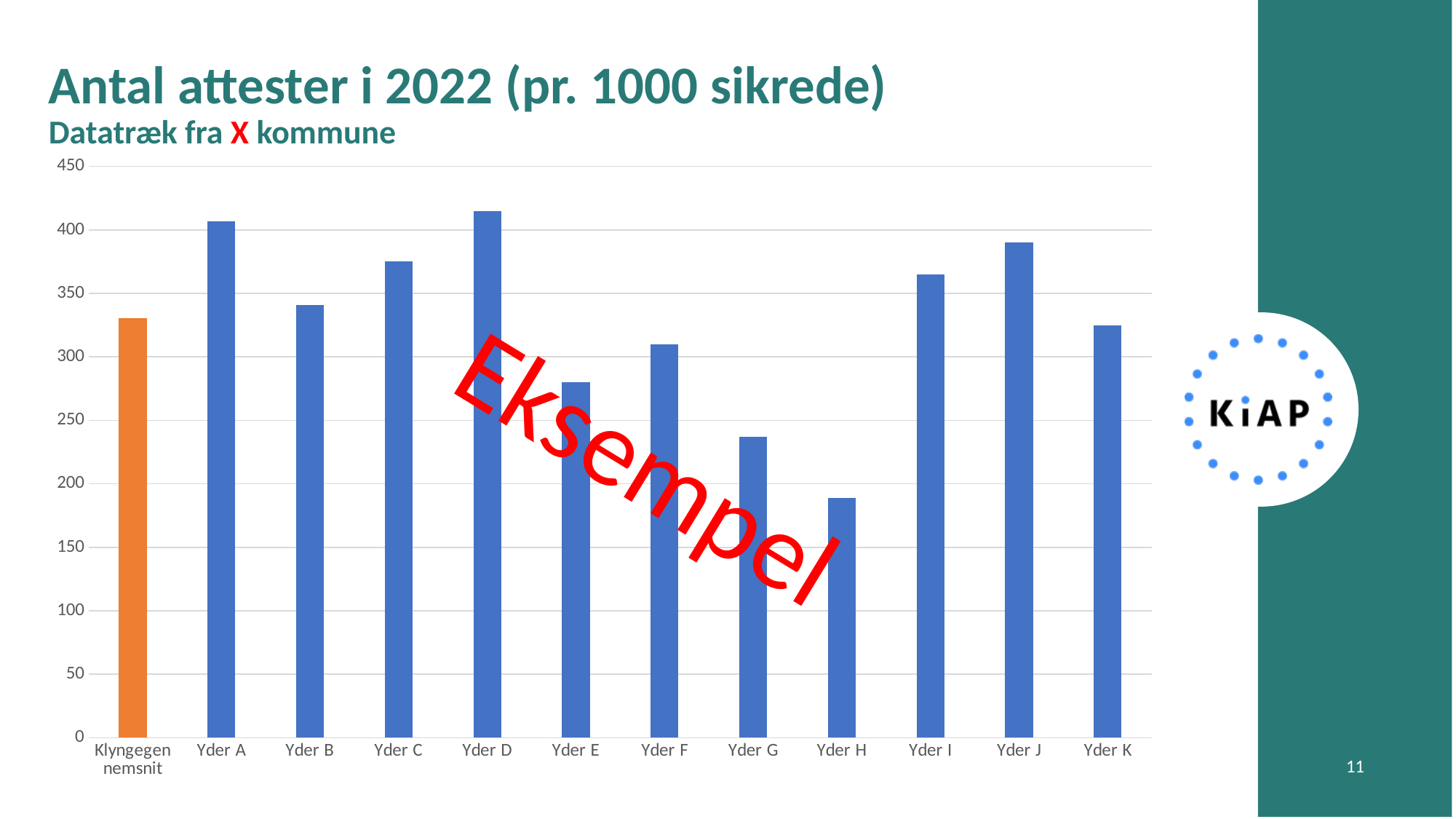
Which category has the highest value in the chart? Yder D Is the value for Yder E greater or less than 300? less How many bars (categories) are plotted in the chart? 12 Is the value for Yder G greater or less than 200? greater What kind of chart is shown on the slide? Bar chart Is the value for Yder A greater or less than 400? greater Which is larger, the value for Yder A or the value for Yder B? Yder A Which is larger, the value for Yder I or the value for Yder E? Yder I Which category is shown with an orange bar instead of a blue one? Klyngegennemsnit Which category has the lowest value in the chart? Yder H